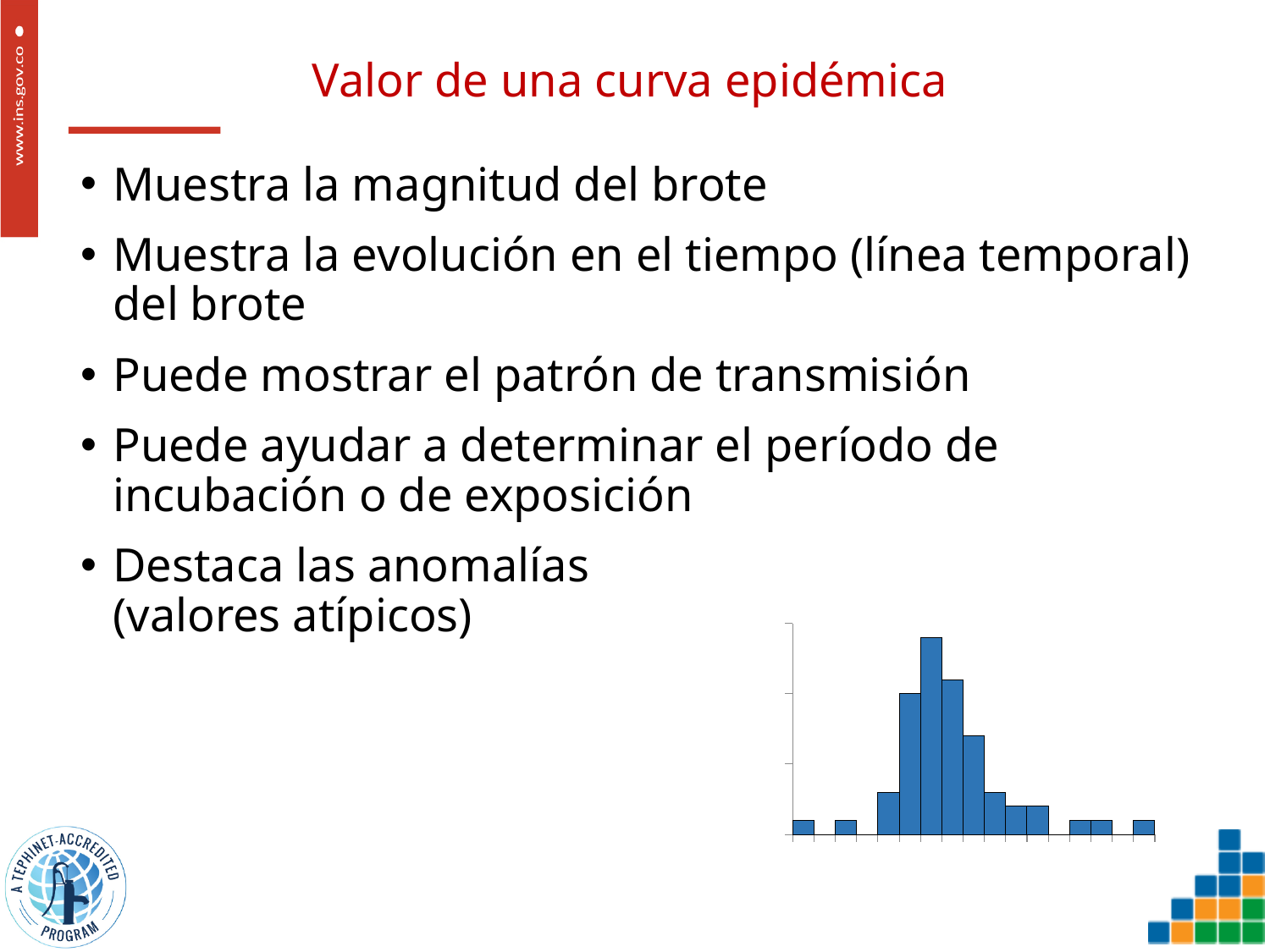
In the chart at the bottom right of the slide, do the bar heights rise or fall moving from the left end of the x axis toward the tallest bar? rise In the chart at the bottom right of the slide, do the bar heights rise or fall moving from the tallest bar toward the right end of the x axis? fall Does the chart at the bottom right of the slide show a legend? No What colour are the bars in the chart at the bottom right of the slide? blue What kind of chart is shown at the bottom right of the slide? bar chart